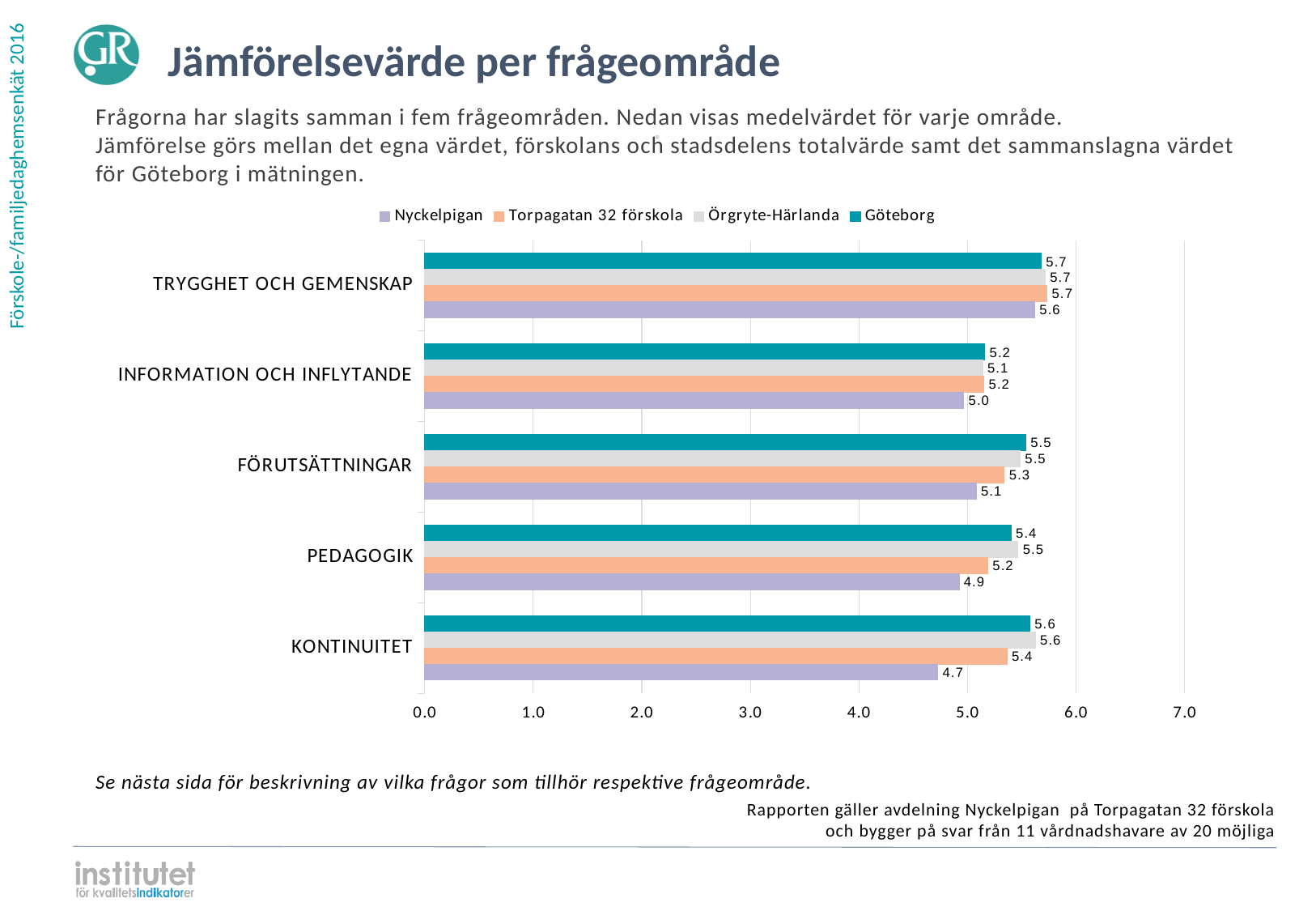
What is the difference between the Göteborg value and the Nyckelpigan value in KONTINUITET? 0.9 What is the value for Nyckelpigan in KONTINUITET? 4.7 How many series does the legend list? 4 How many question areas (categories) are shown on the chart? 5 Is the value for Nyckelpigan in PEDAGOGIK greater or less than 5.0? less What is the value for Göteborg in TRYGGHET OCH GEMENSKAP? 5.7 What kind of chart is shown on the slide? bar chart What is the value for Torpagatan 32 förskola in PEDAGOGIK? 5.2 In PEDAGOGIK, which is larger: the value for Örgryte-Härlanda or the value for Nyckelpigan? Örgryte-Härlanda What is the value for Örgryte-Härlanda in FÖRUTSÄTTNINGAR? 5.5 In which question area does Nyckelpigan have its lowest value? KONTINUITET In which question area does Nyckelpigan have its highest value? TRYGGHET OCH GEMENSKAP